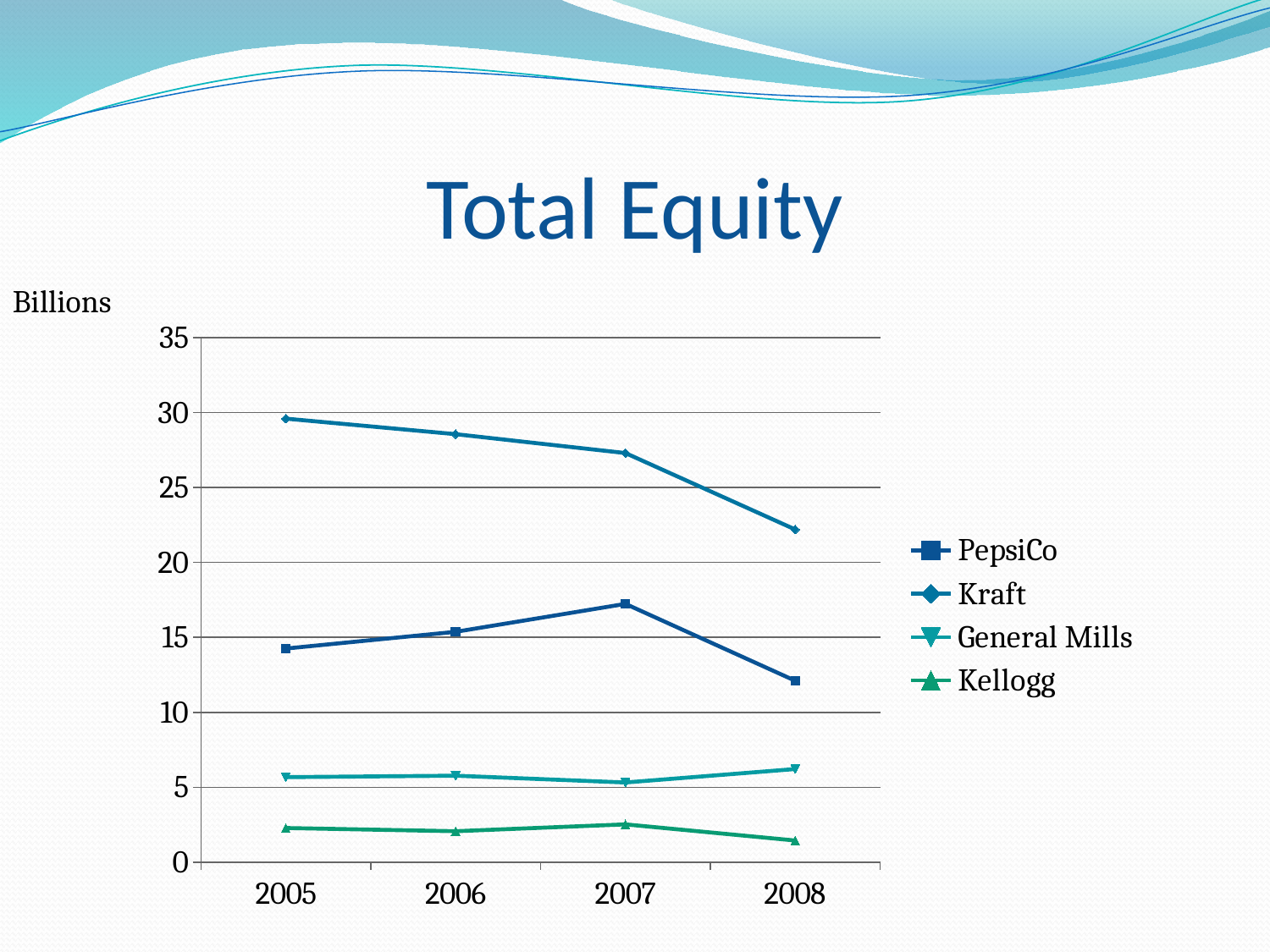
Which company has the lowest total equity in 2008? Kellogg How many years are shown on the x axis? 4 How many series does the legend list? 4 Is Kellogg's total equity in 2007 greater or less than 5? less Which is larger in 2008, PepsiCo's total equity or General Mills' total equity? PepsiCo Does Kraft's total equity rise or fall from 2005 to 2008? fall What is the title of the chart? Total Equity Is Kraft's total equity in 2005 greater or less than 25? greater Is PepsiCo's total equity in 2007 greater or less than 15? greater What type of chart is shown on the slide? line chart Which company has the highest total equity in 2005? Kraft